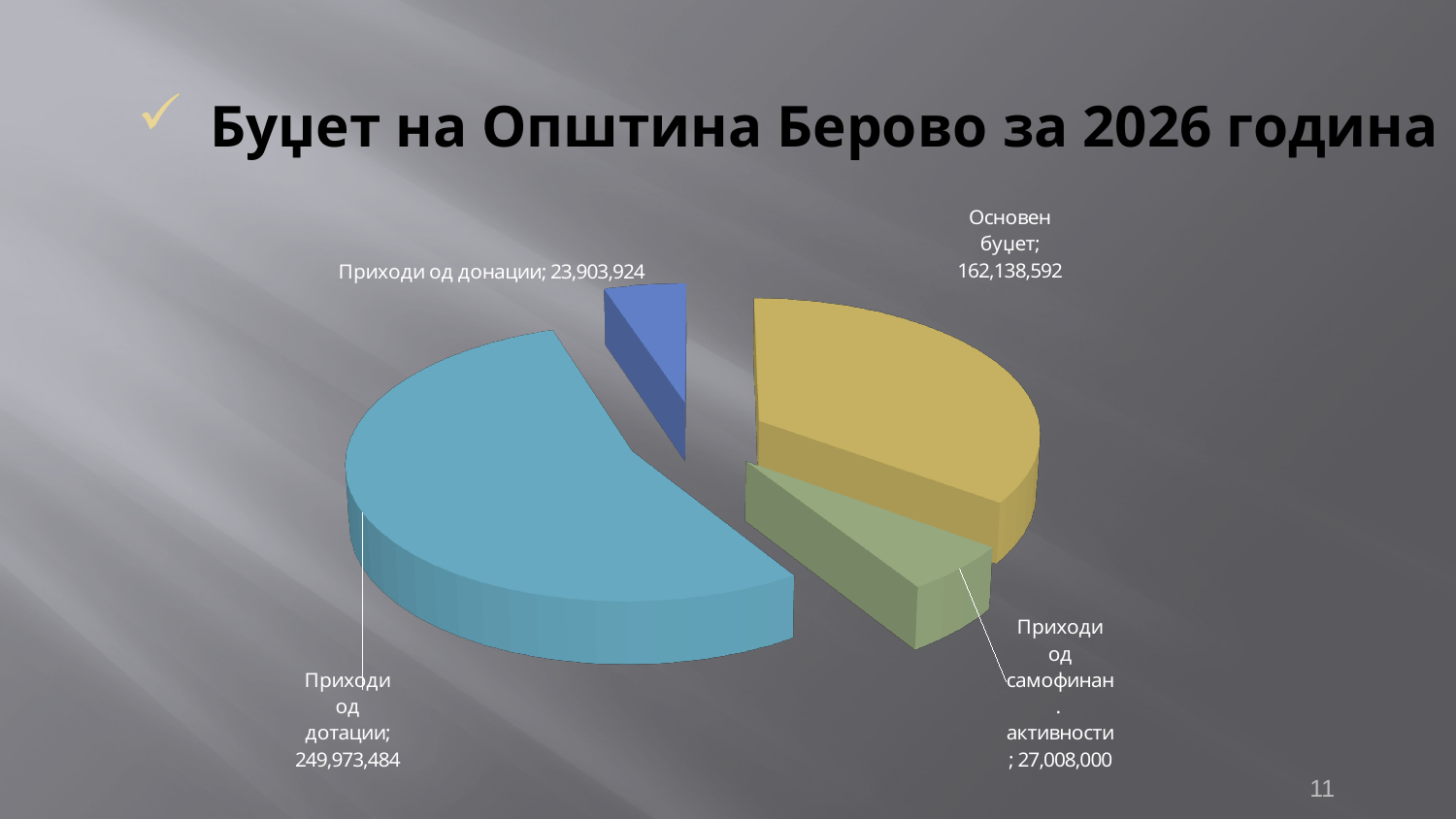
What is the value for Приходи од донации? 23,903,924 What is the difference between Приходи од дотации and Основен буџет? 87,834,892 What is the value for Основен буџет? 162,138,592 Which category has the smallest slice of the pie? Приходи од донации What is the value for Приходи од самофинан. активности? 27,008,000 Which is larger, Приходи од самофинан. активности or Приходи од донации? Приходи од самофинан. активности How many slices does the pie chart have? 4 What is the title of the slide containing the chart? Буџет на Општина Берово за 2026 година Which category has the largest slice of the pie? Приходи од дотации What kind of chart is shown on the slide? Pie chart What is the value for Приходи од дотации? 249,973,484